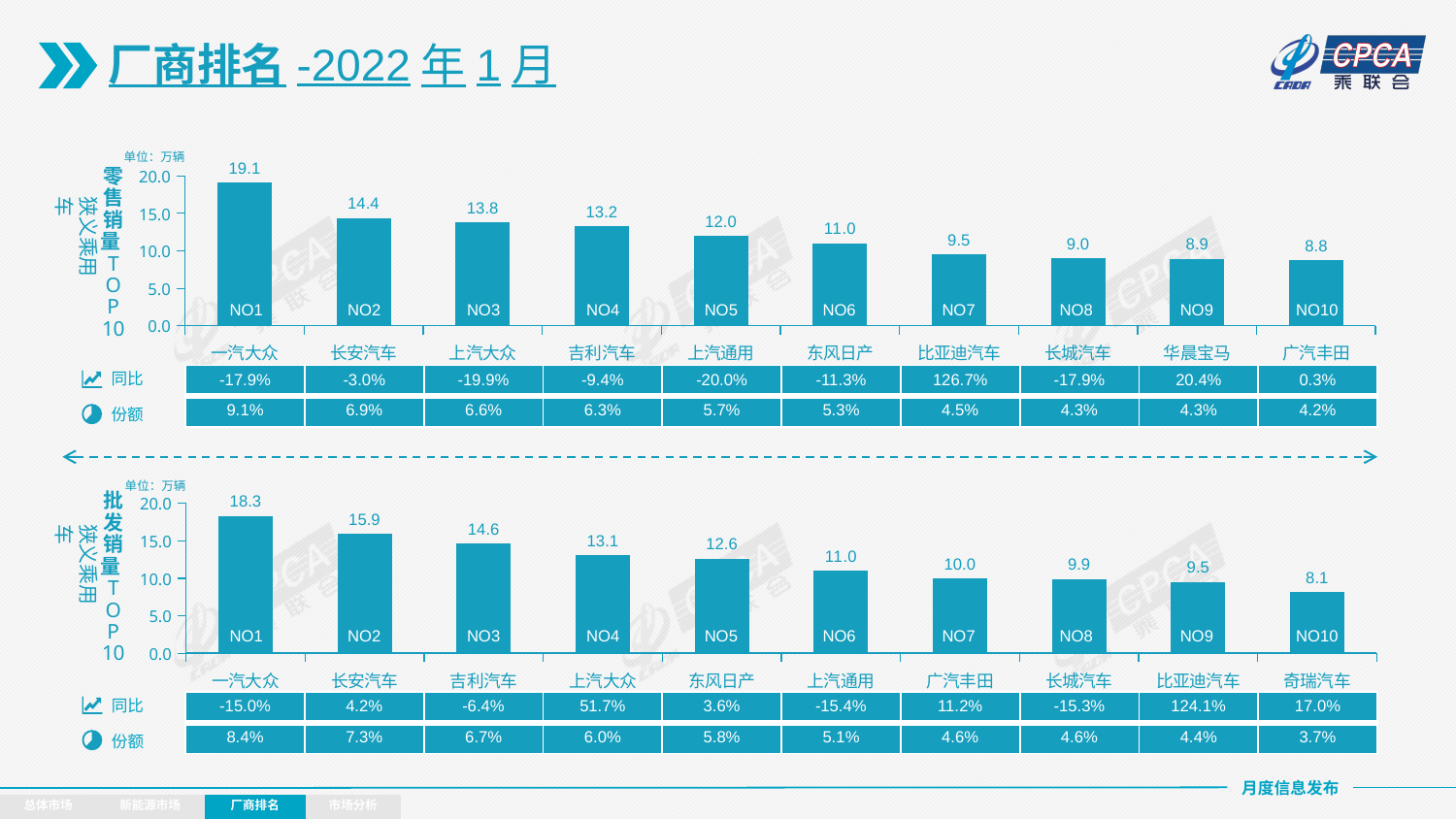
What type of chart is the top chart (零售销量 TOP10)? bar chart In the top chart (零售销量 TOP10), how many manufacturers are shown? 10 In the bottom chart (批发销量 TOP10), what is the value for 奇瑞汽车? 8.1 In the bottom chart (批发销量 TOP10), which is larger, the value for 长安汽车 or the value for 上汽大众? 长安汽车 In the bottom chart (批发销量 TOP10), what is the difference between the values for 一汽大众 and 长安汽车? 2.4 In the top chart (零售销量 TOP10), what is the difference between the values for 一汽大众 and 长安汽车? 4.7 In the top chart (零售销量 TOP10), what is the value for 比亚迪汽车? 9.5 In the top chart (零售销量 TOP10), which manufacturer has the lowest value? 广汽丰田 In the top chart (零售销量 TOP10), what is the value for 一汽大众? 19.1 In the bottom chart (批发销量 TOP10), which manufacturer has the highest value? 一汽大众 In the bottom chart (批发销量 TOP10), do the values rise or fall from left to right? fall In the bottom chart (批发销量 TOP10), what is the value for 吉利汽车? 14.6